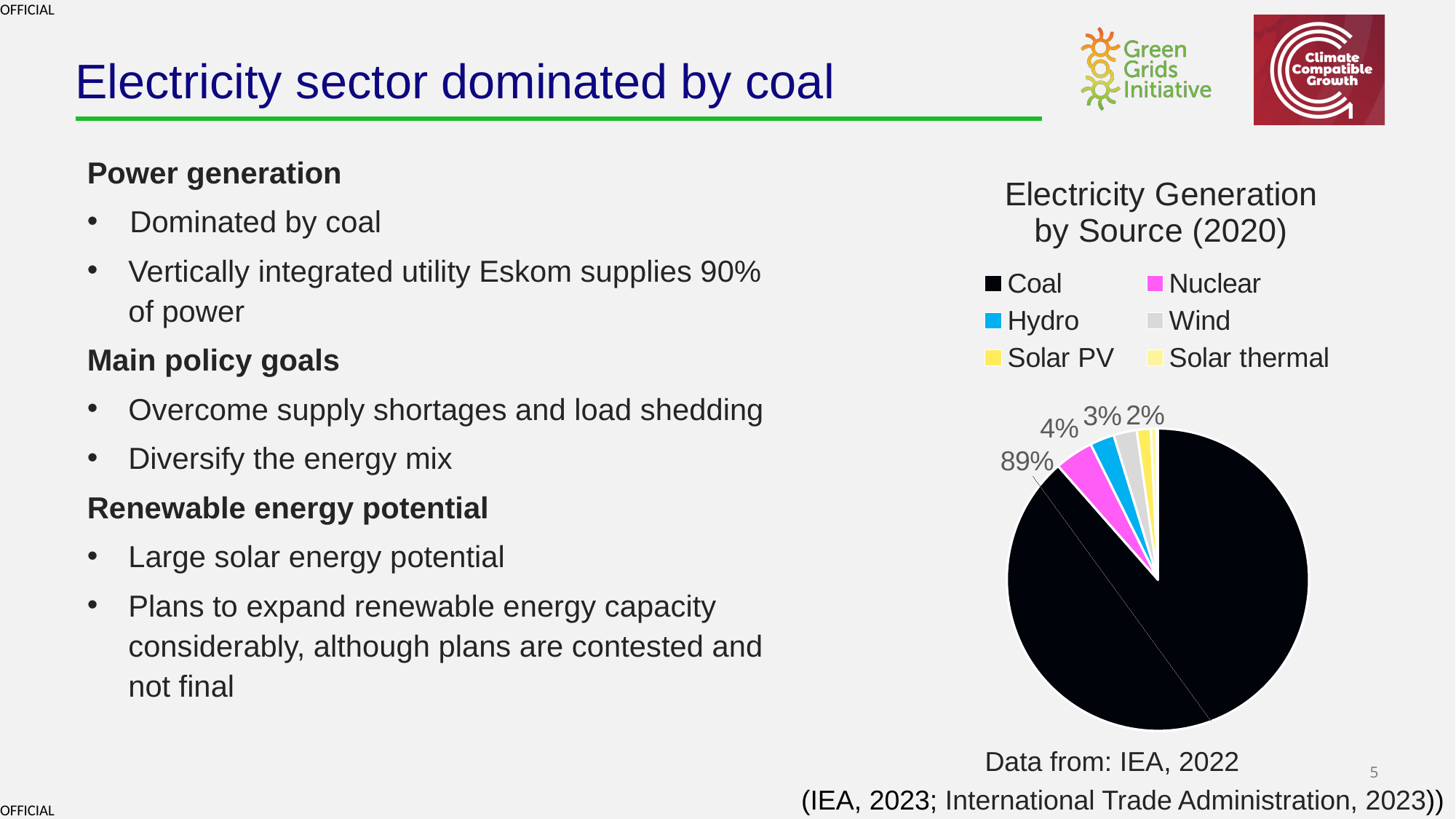
What is the share of Hydro in the Electricity Generation by Source (2020) pie chart? 3% What type of chart is shown on the slide? Pie chart What colour represents Coal in the pie chart? Black Is the share for Coal in the pie chart greater or less than 50%? greater Which is larger in the pie chart, the share for Nuclear or the share for Hydro? Nuclear What percentage of electricity generation comes from Nuclear according to the pie chart? 4% By how many percentage points does Coal's share exceed Nuclear's share in the pie chart? 85 percentage points What share of electricity generation does Coal account for in the pie chart? 89% What percentage does Wind contribute in the pie chart? 2% How many sources are listed in the legend of the pie chart? 6 Which source has the largest slice in the pie chart? Coal What is the title of the chart on the slide? Electricity Generation by Source (2020)